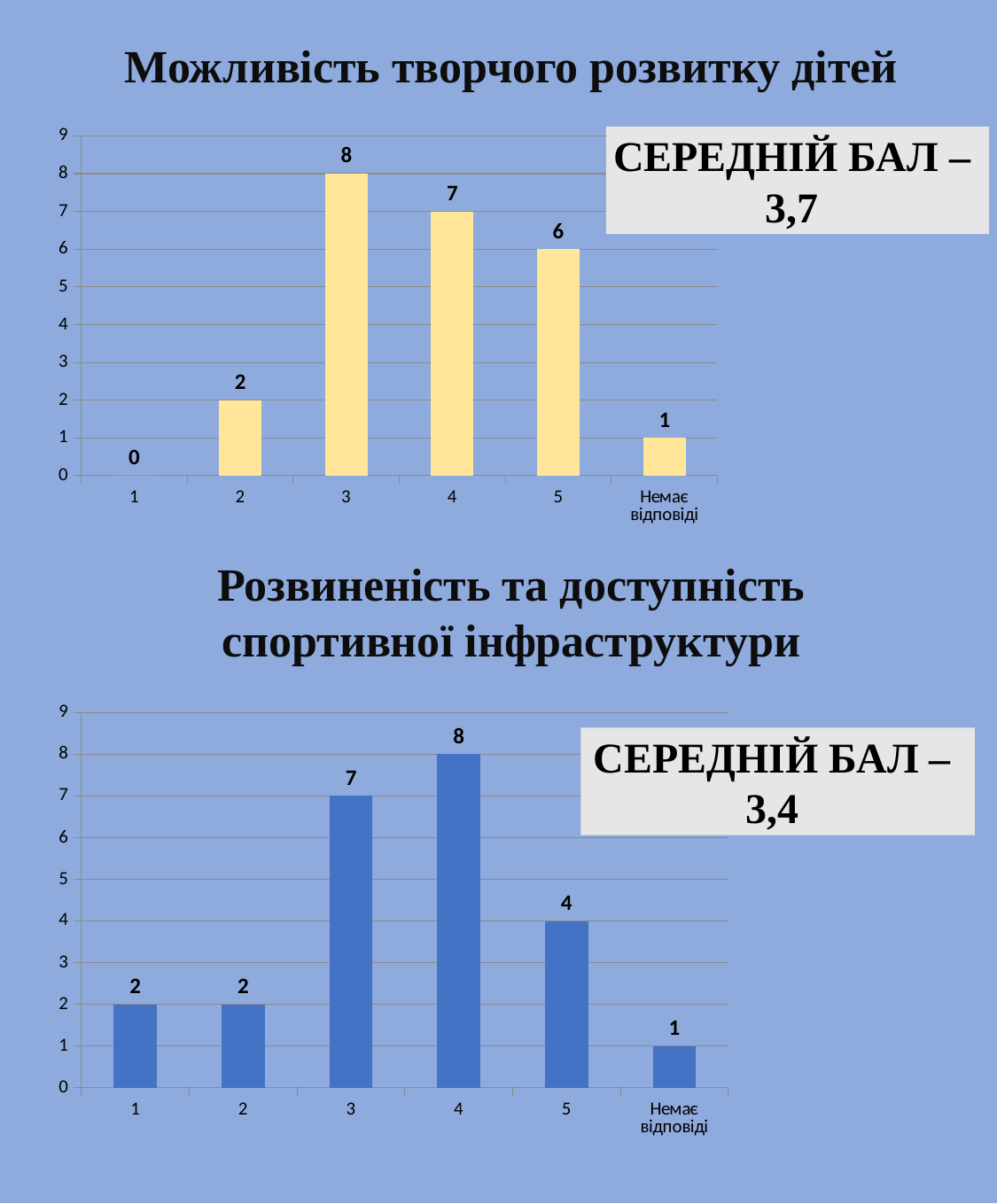
In the bottom chart (Розвиненість та доступність спортивної інфраструктури), what is the value for category 5? 4 In the bottom chart (Розвиненість та доступність спортивної інфраструктури), which category has the highest value? 4 In the top chart (Можливість творчого розвитку дітей), what is the value for category 3? 8 What kind of chart is the bottom chart (Розвиненість та доступність спортивної інфраструктури)? bar chart What colour are the bars in the bottom chart (Розвиненість та доступність спортивної інфраструктури)? blue In the bottom chart (Розвиненість та доступність спортивної інфраструктури), what is the difference between the values for category 4 and category 1? 6 In the top chart (Можливість творчого розвитку дітей), what is the difference between the values for category 3 and category 5? 2 In the top chart (Можливість творчого розвитку дітей), what is the value for 'Немає відповіді'? 1 In the top chart (Можливість творчого розвитку дітей), which category has the lowest value? 1 In the top chart (Можливість творчого розвитку дітей), how many categories are shown on the x axis? 6 In the bottom chart (Розвиненість та доступність спортивної інфраструктури), which is larger: the value for category 3 or category 5? 3 What average score (СЕРЕДНІЙ БАЛ) is shown next to the top chart? 3,7